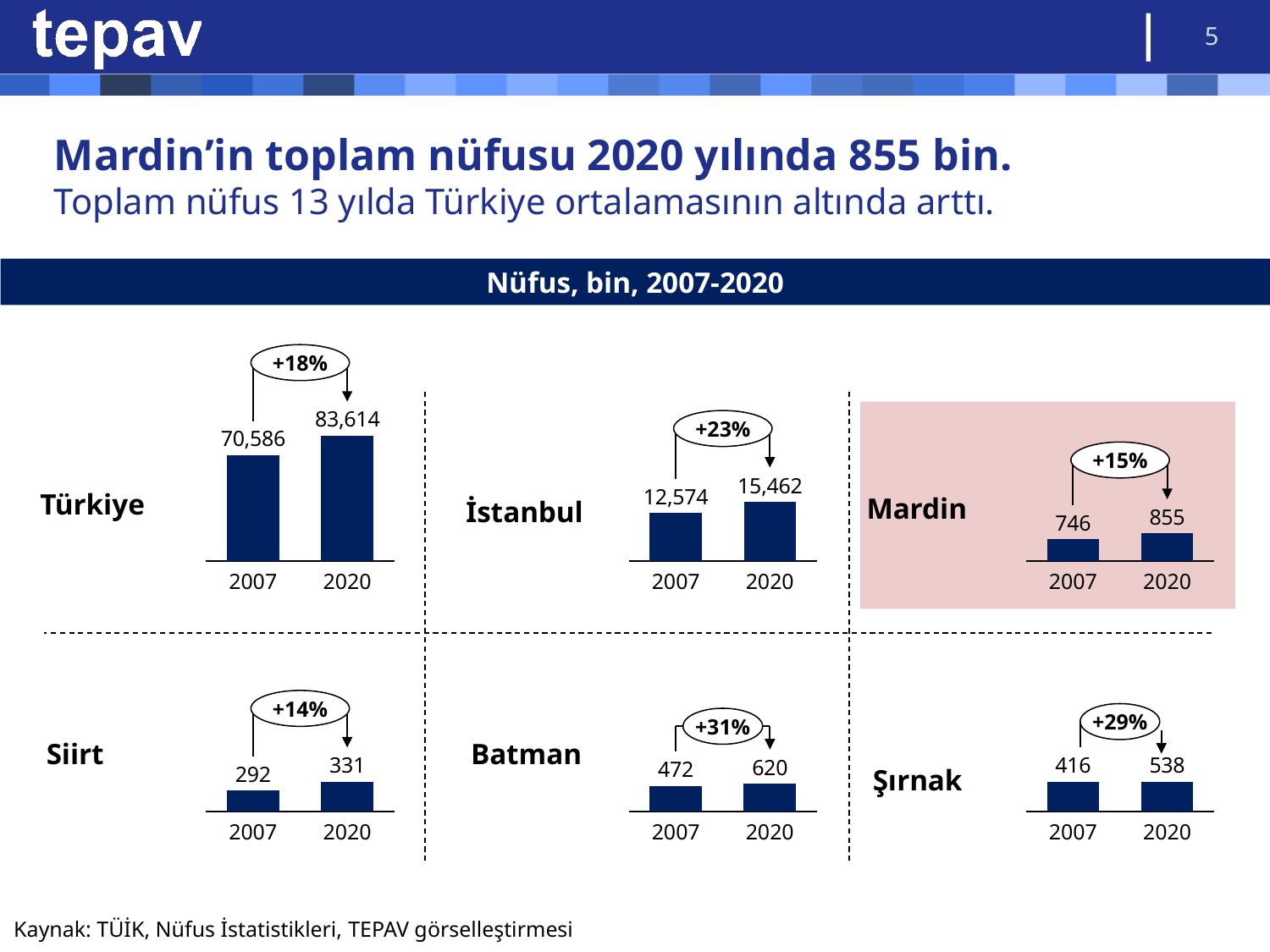
In the Batman chart, what is the population value shown for 2007? 472 In the Siirt chart, what is the difference between the 2020 and 2007 values? 39 In the Mardin chart, what is the population value shown for 2020? 855 Which of the six charts has the highest percentage change shown? Batman In the Türkiye chart, what is the population value shown for 2007? 70,586 In the Şırnak chart, what percentage change is shown between 2007 and 2020? +29% In the İstanbul chart, what is the population value shown for 2020? 15,462 In the Batman chart, which year has the higher value, 2007 or 2020? 2020 In the Mardin chart, what is the difference between the 2020 and 2007 values? 109 How many bars are shown in the Şırnak chart? 2 What type of chart is used for the Siirt panel? bar chart In the Türkiye chart, do the values rise or fall from 2007 to 2020? rise